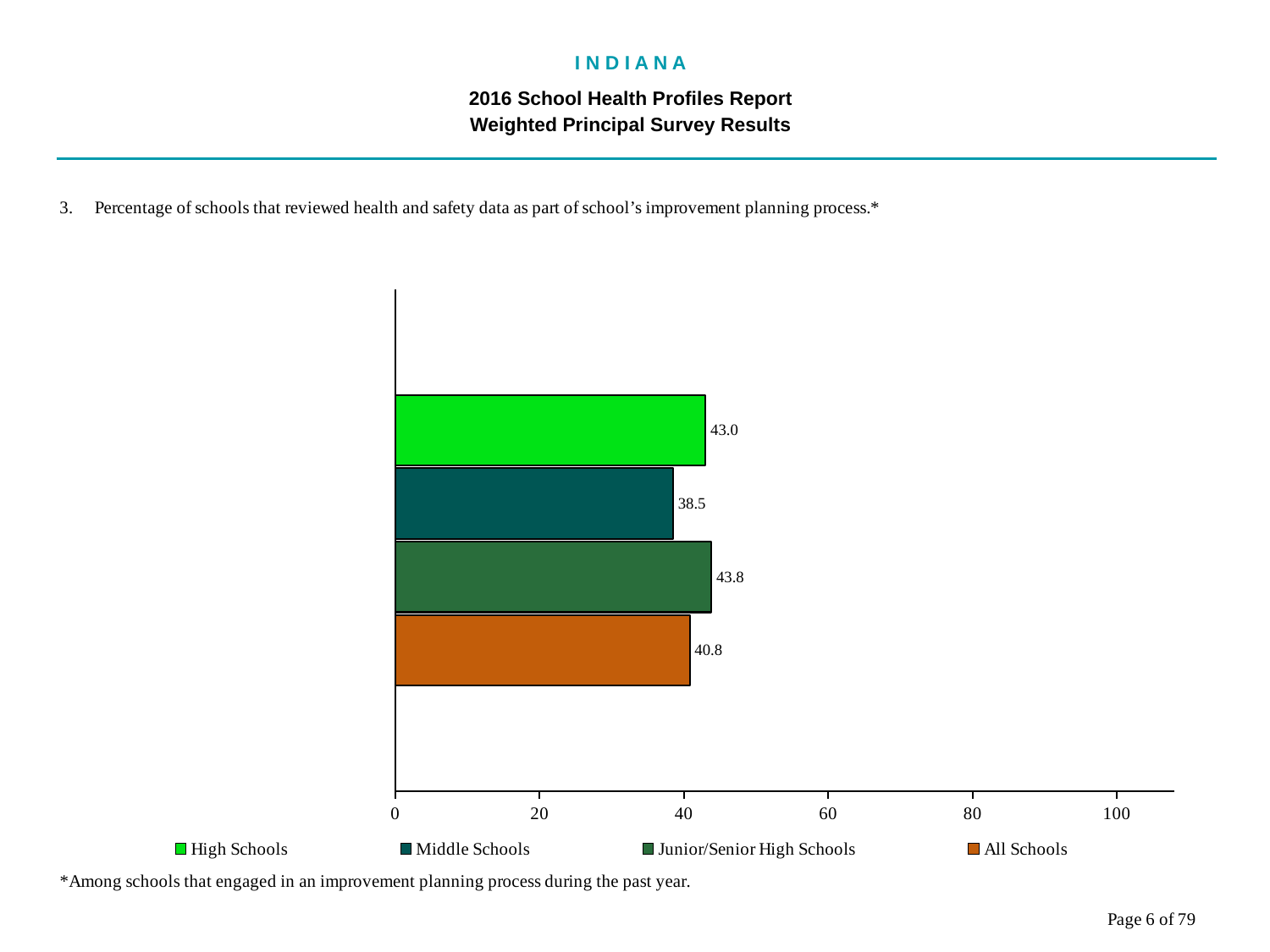
How many bars are plotted in the chart? 4 How many entries does the legend list? 4 What is the value for High Schools? 43.0 What is the difference between the values for High Schools and Middle Schools? 4.5 Which is larger, the value for All Schools or the value for Middle Schools? All Schools What is the value for Middle Schools? 38.5 Which school type has the lowest value? Middle Schools Which school type has the highest value? Junior/Senior High Schools What kind of chart is shown on the slide? bar chart What is the value for Junior/Senior High Schools? 43.8 Is the value for Middle Schools greater or less than 40? less What is the value for All Schools? 40.8